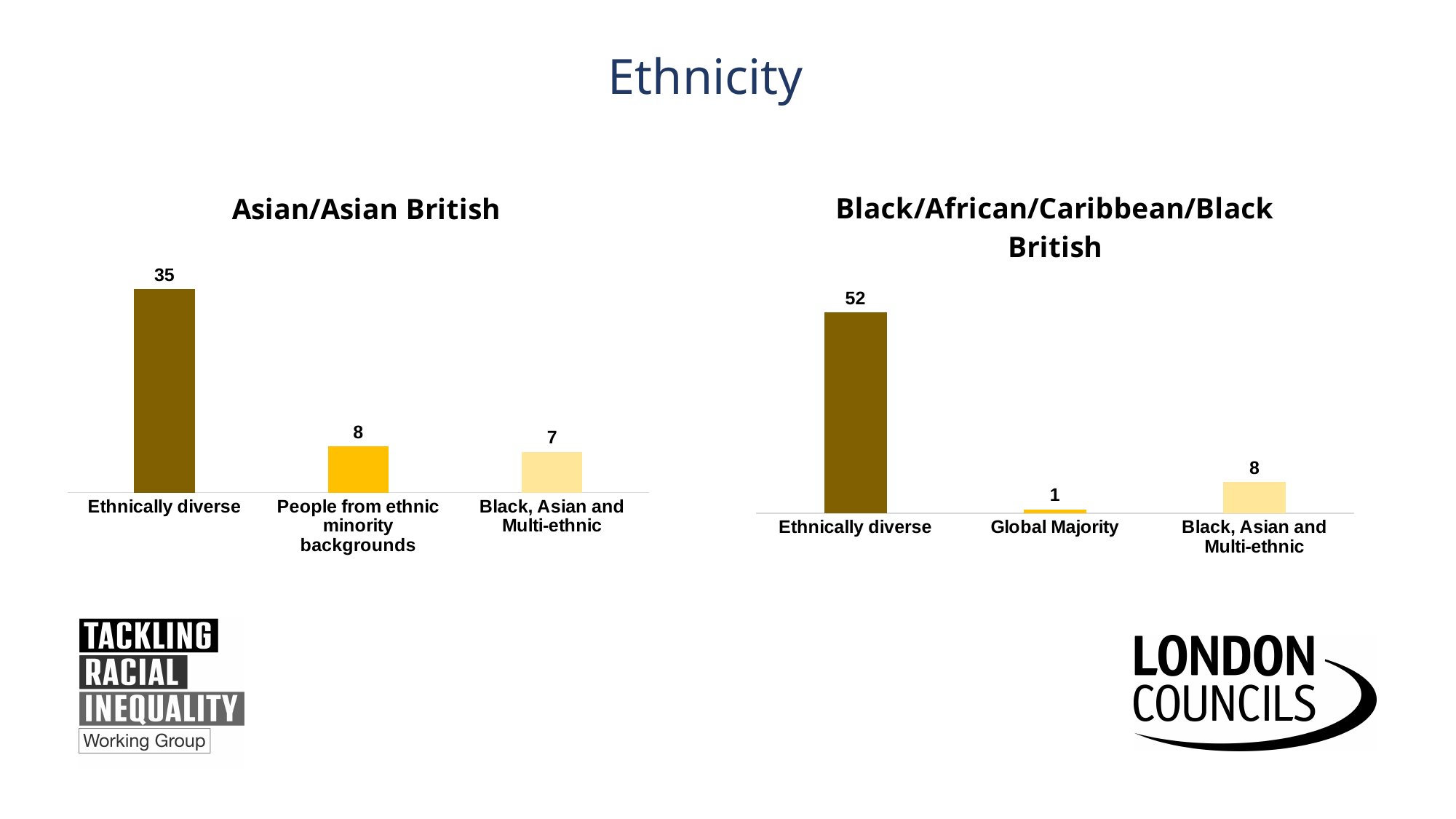
In the 'Black/African/Caribbean/Black British' chart, which category has the lowest value? Global Majority In the 'Black/African/Caribbean/Black British' chart, what is the difference between 'Ethnically diverse' and 'Black, Asian and Multi-ethnic'? 44 What type of chart is the 'Asian/Asian British' chart? Bar chart In the 'Black/African/Caribbean/Black British' chart, what is the value for 'Black, Asian and Multi-ethnic'? 8 How many categories are shown in the 'Black/African/Caribbean/Black British' chart? 3 What is the title of the chart on the left of the slide? Asian/Asian British In the 'Asian/Asian British' chart, what is the value for 'Ethnically diverse'? 35 Which is larger: 'Ethnically diverse' in the 'Asian/Asian British' chart or 'Ethnically diverse' in the 'Black/African/Caribbean/Black British' chart? Black/African/Caribbean/Black British In the 'Asian/Asian British' chart, what is the difference between 'Ethnically diverse' and 'Black, Asian and Multi-ethnic'? 28 In the 'Asian/Asian British' chart, which category has the highest value? Ethnically diverse In the 'Asian/Asian British' chart, what is the value for 'People from ethnic minority backgrounds'? 8 In the 'Black/African/Caribbean/Black British' chart, what is the value for 'Global Majority'? 1